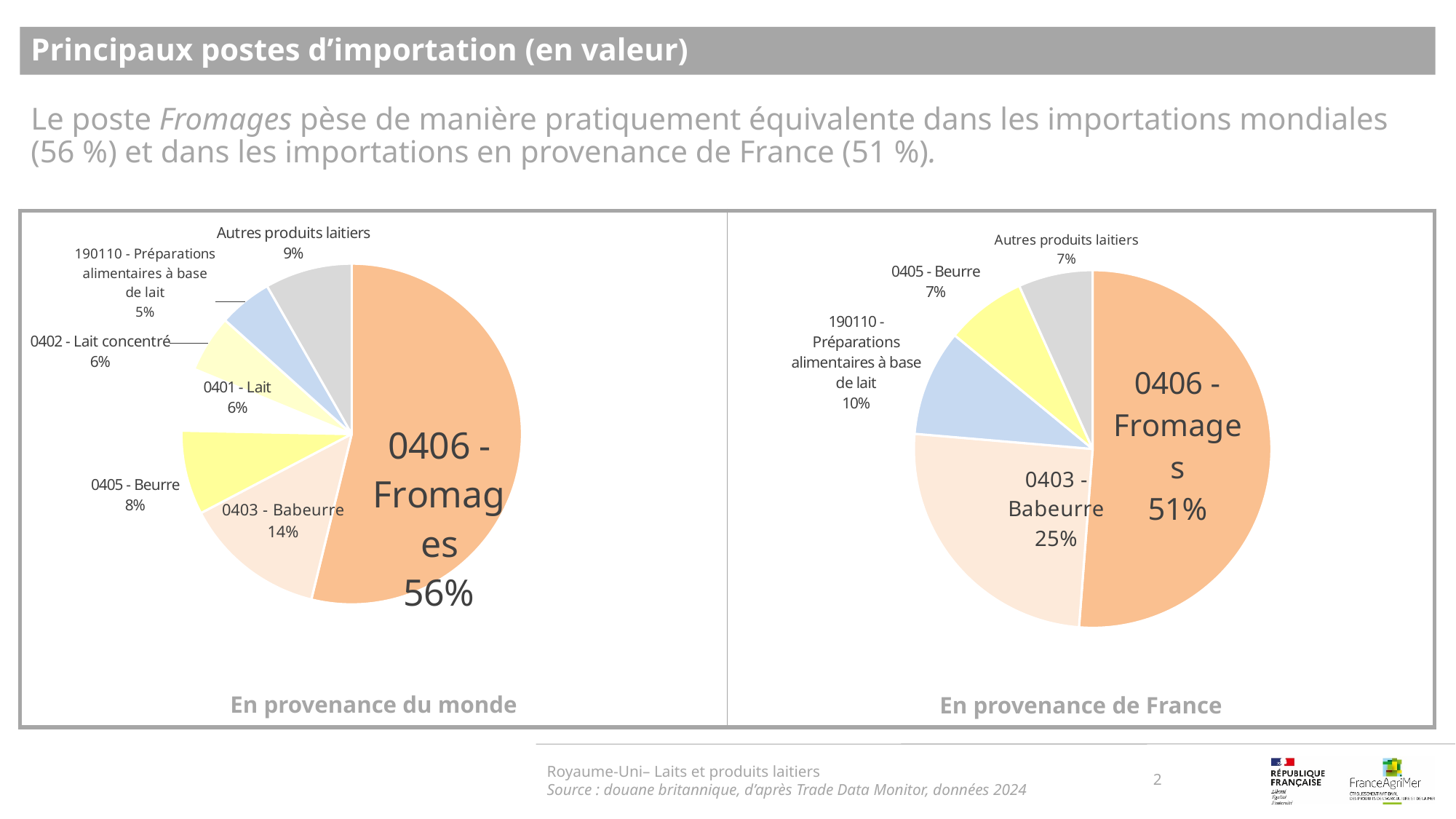
Which is larger: the share of 0403 - Babeurre in the 'En provenance du monde' chart or in the 'En provenance de France' chart? En provenance de France In the 'En provenance du monde' chart, which category has the largest share? 0406 - Fromages In the 'En provenance du monde' chart, what is the difference between the shares of 0403 - Babeurre and 0405 - Beurre? 6 percentage points In the 'En provenance de France' chart, what share does 190110 - Préparations alimentaires à base de lait have? 10% How many slices does the 'En provenance de France' pie chart have? 5 In the 'En provenance du monde' chart, what share does 0405 - Beurre have? 8% In the 'En provenance du monde' chart, what share does 0406 - Fromages have? 56% In the 'En provenance du monde' chart, which category has the smallest share? 190110 - Préparations alimentaires à base de lait What type of chart is used on this slide? Pie chart What is the difference between the share of 0406 - Fromages in the 'En provenance du monde' chart and in the 'En provenance de France' chart? 5 percentage points In the 'En provenance de France' chart, what share does 0403 - Babeurre have? 25% In the 'En provenance de France' chart, which category has the largest share? 0406 - Fromages